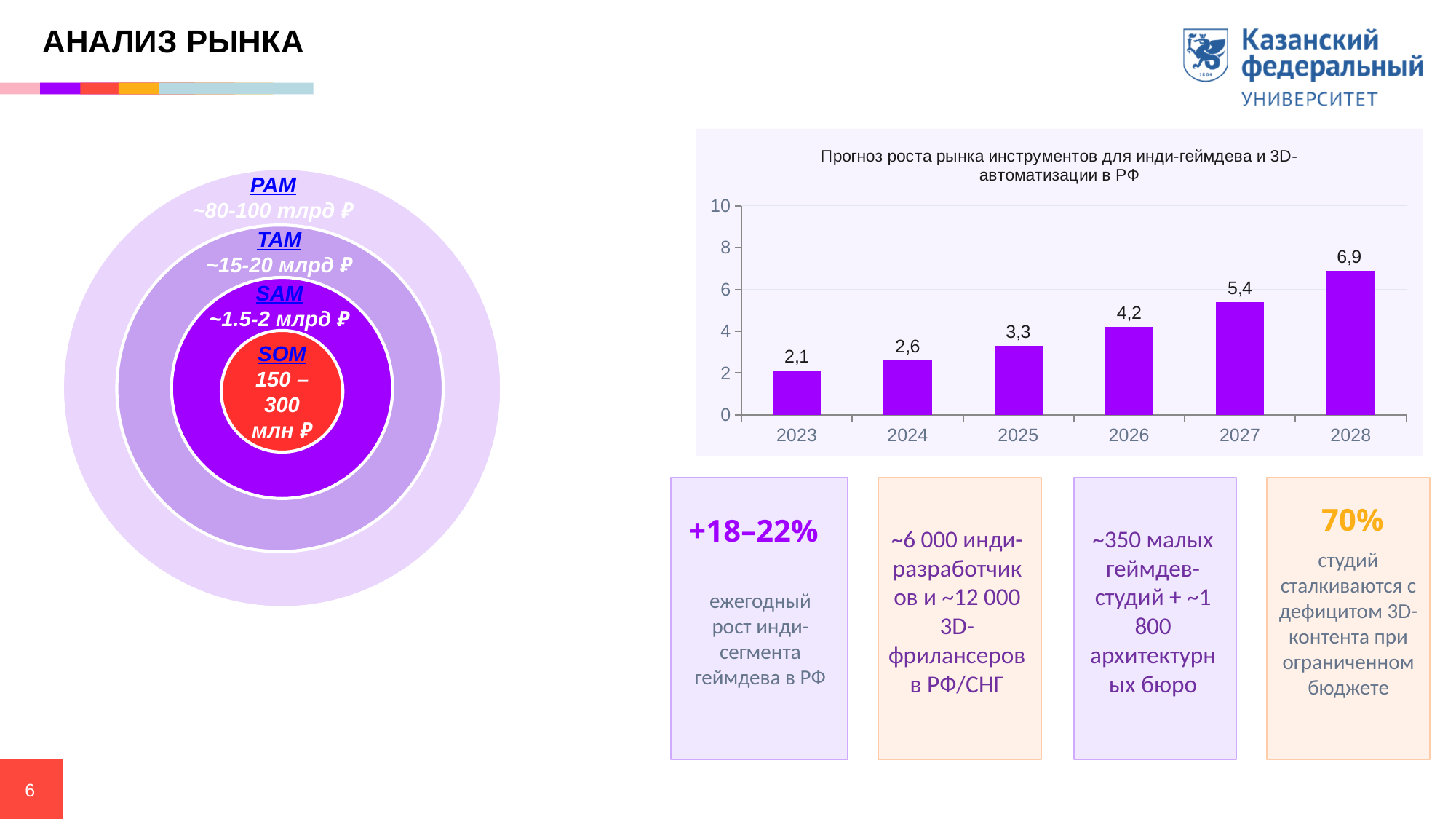
In the bar chart, is the value for 2027 greater or less than 4? greater In the bar chart, what is the difference between the values for 2028 and 2023? 4,8 How many years are shown on the x axis of the bar chart? 6 In the bar chart, which is larger, the value for 2025 or the value for 2027? 2027 In the bar chart, which year has the highest value? 2028 In the bar chart, what is the difference between the values for 2027 and 2026? 1,2 In the bar chart, what is the value for 2026? 4,2 What kind of chart is the chart on the right side of the slide? bar chart In the bar chart, do the values rise or fall from 2023 to 2028? rise In the bar chart, which year has the lowest value? 2023 In the bar chart, what is the value for 2023? 2,1 In the bar chart, what is the value for 2028? 6,9